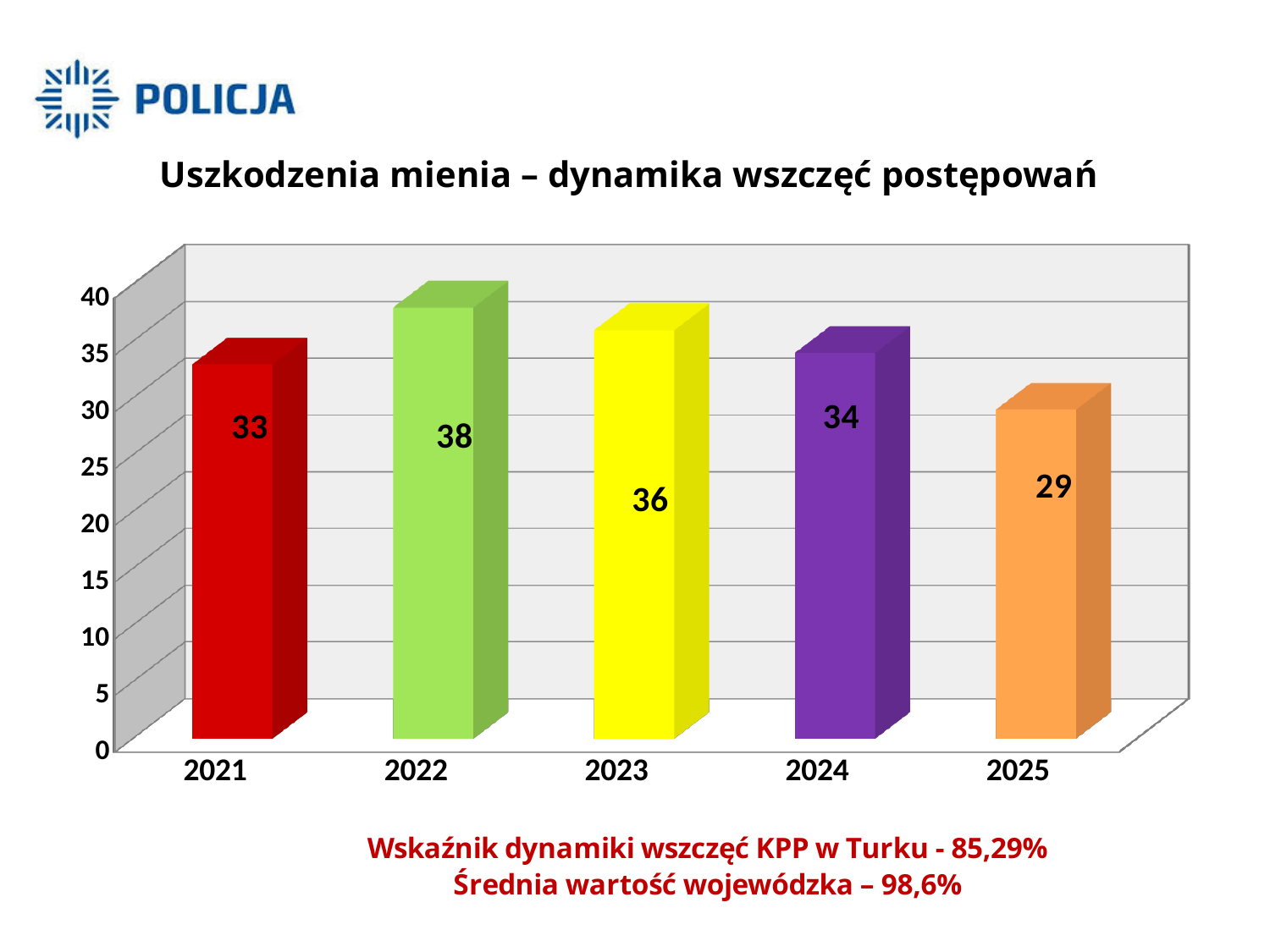
What is the value for 2025? 29 Which year has the lowest value? 2025 Is the value for 2022 greater or less than 35? greater Which year has the highest value? 2022 What is the value for 2023? 36 What is the difference between the values for 2022 and 2025? 9 What is the value for 2021? 33 Which is larger, the value for 2023 or the value for 2024? 2023 What is the title of the chart? Uszkodzenia mienia – dynamika wszczęć postępowań What kind of chart is shown on the slide? bar chart Do the values rise or fall from 2022 to 2025? fall How many years are shown on the x axis? 5